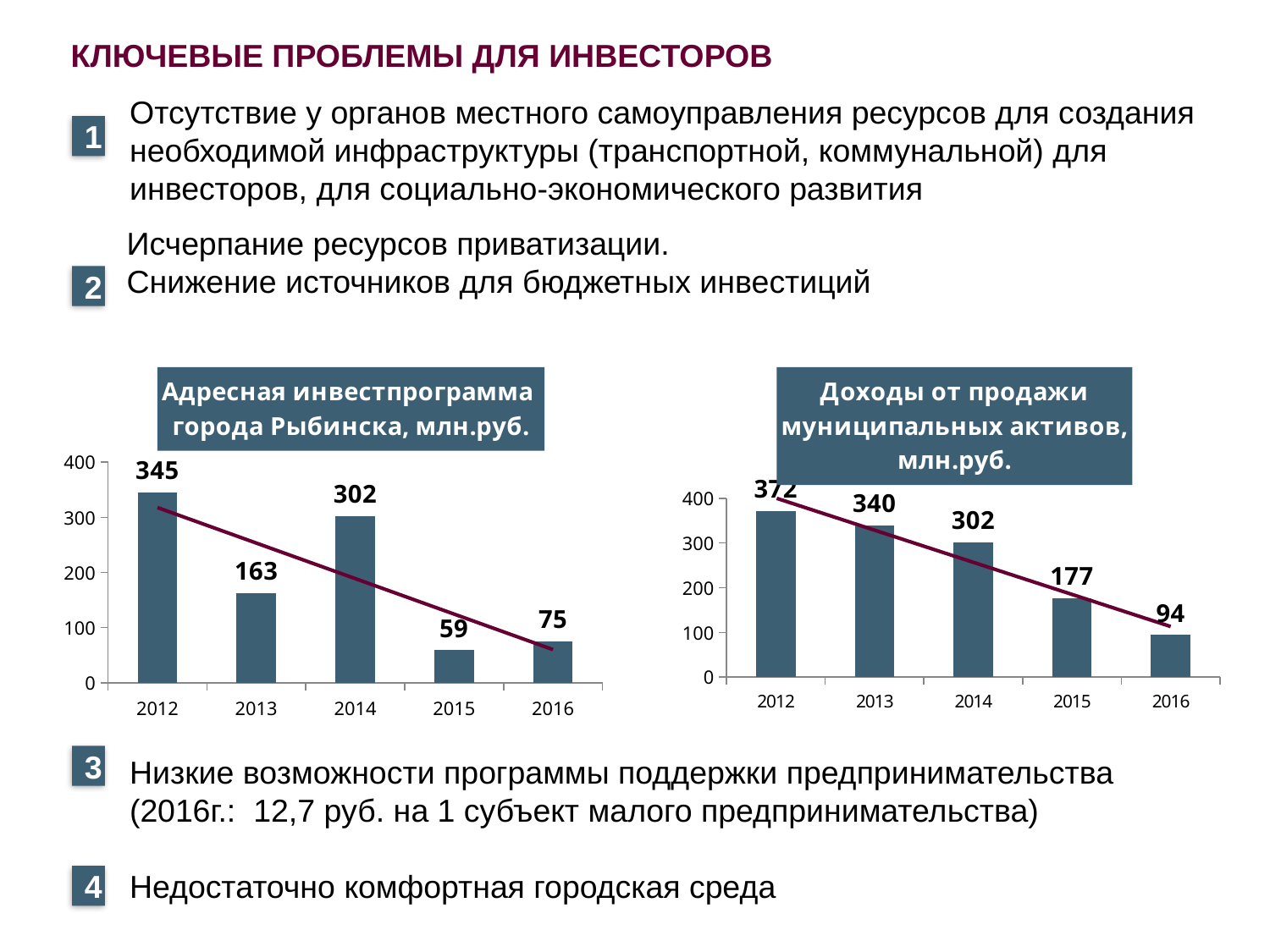
In the chart 'Доходы от продажи муниципальных активов, млн.руб.', do the values rise or fall from 2012 to 2016? fall What kind of chart is 'Адресная инвестпрограмма города Рыбинска, млн.руб.'? bar chart In the chart 'Доходы от продажи муниципальных активов, млн.руб.', which is larger, the value for 2014 or the value for 2016? 2014 In the chart 'Адресная инвестпрограмма города Рыбинска, млн.руб.', what is the difference between the values for 2012 and 2016? 270 In the chart 'Адресная инвестпрограмма города Рыбинска, млн.руб.', what is the value for 2014? 302 In the chart 'Доходы от продажи муниципальных активов, млн.руб.', what is the difference between the values for 2013 and 2014? 38 In the chart 'Доходы от продажи муниципальных активов, млн.руб.', is the value for 2016 greater or less than 100? less In the chart 'Доходы от продажи муниципальных активов, млн.руб.', what is the value for 2015? 177 In the chart 'Адресная инвестпрограмма города Рыбинска, млн.руб.', which year has the lowest value? 2015 In the chart 'Адресная инвестпрограмма города Рыбинска, млн.руб.', which year has the highest value? 2012 In the chart 'Адресная инвестпрограмма города Рыбинска, млн.руб.', how many years are shown on the x axis? 5 In the chart 'Доходы от продажи муниципальных активов, млн.руб.', which year has the highest value? 2012